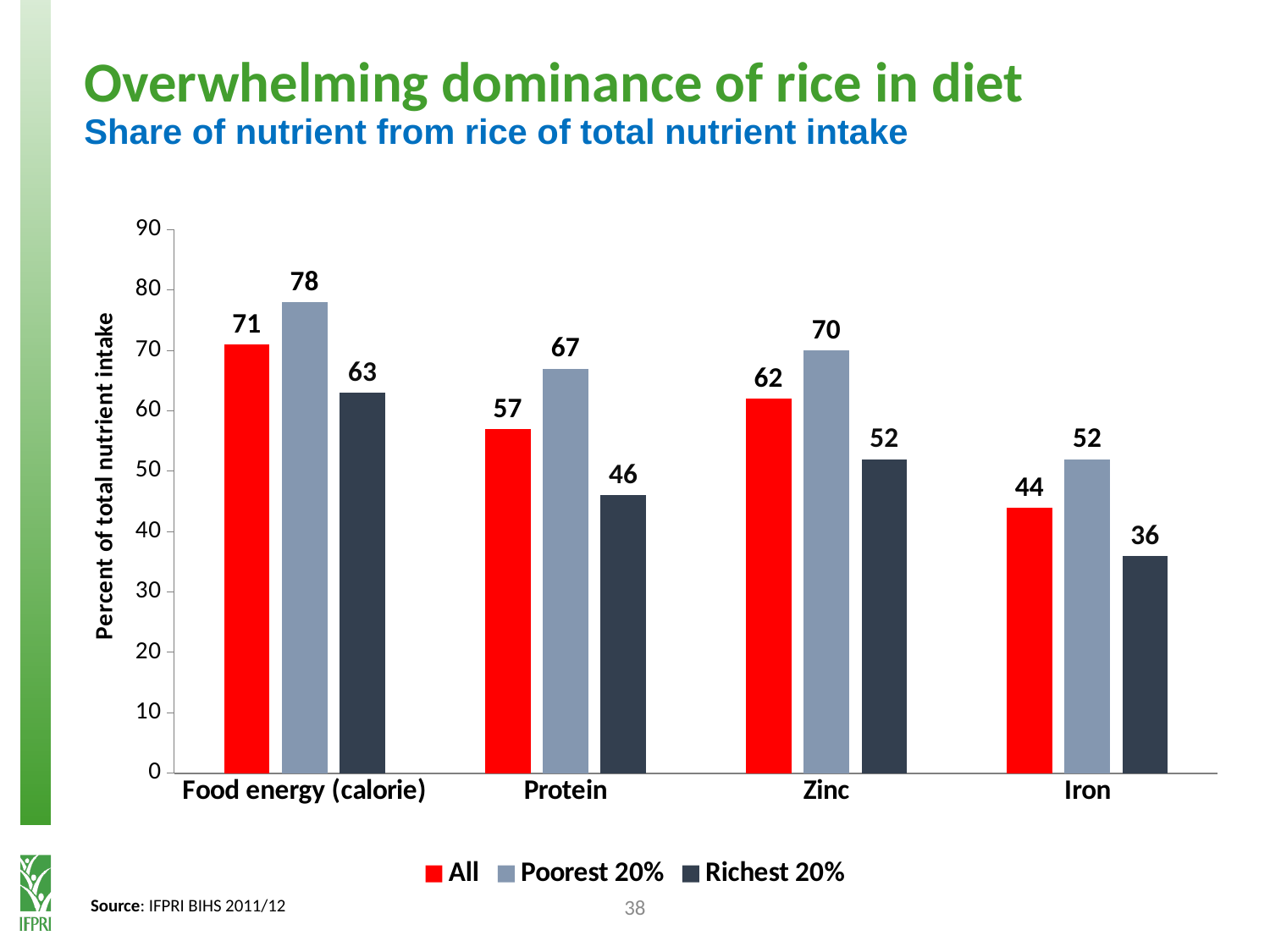
What is the value for All for Zinc? 62 Which category has the highest value for the All series? Food energy (calorie) Which is larger for Zinc: the Poorest 20% value or the Richest 20% value? Poorest 20% How many categories are shown on the x axis? 4 Which category has the lowest value for the Richest 20% series? Iron What is the value for Poorest 20% for Food energy (calorie)? 78 What is the label of the y axis? Percent of total nutrient intake Does the Richest 20% series rise or fall from Food energy (calorie) to Protein? Fall What is the difference between the Poorest 20% and Richest 20% values for Protein? 21 What is the value for Richest 20% for Iron? 36 What kind of chart is shown on the slide? Bar chart How many series does the legend list? 3